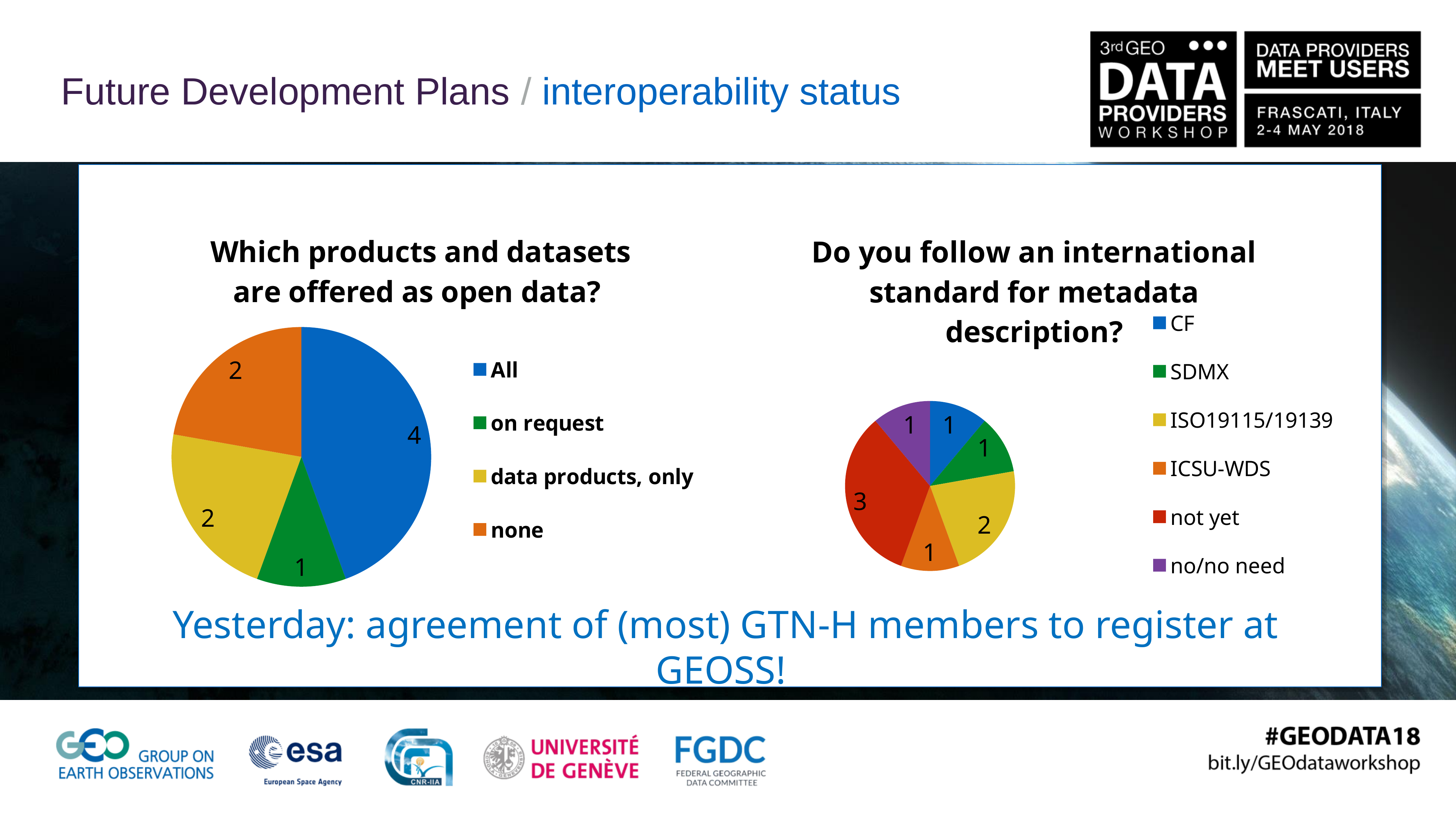
In the right chart 'Do you follow an international standard for metadata description?', which is larger, 'not yet' or 'ISO19115/19139'? not yet In the right chart 'Do you follow an international standard for metadata description?', what is the value for 'not yet'? 3 How many categories does the legend of the right chart 'Do you follow an international standard for metadata description?' list? 6 In the right chart 'Do you follow an international standard for metadata description?', what is the value for 'ISO19115/19139'? 2 What kind of chart is the left chart titled 'Which products and datasets are offered as open data?'? pie chart In the left chart 'Which products and datasets are offered as open data?', which category has the smallest slice? on request In the left chart 'Which products and datasets are offered as open data?', what is the value for 'on request'? 1 In the left chart 'Which products and datasets are offered as open data?', what is the difference between the values for 'All' and 'none'? 2 In the left chart 'Which products and datasets are offered as open data?', what is the value for 'All'? 4 In the right chart 'Do you follow an international standard for metadata description?', which category has the largest slice? not yet How many categories does the legend of the left chart 'Which products and datasets are offered as open data?' list? 4 In the left chart 'Which products and datasets are offered as open data?', which category has the largest slice? All